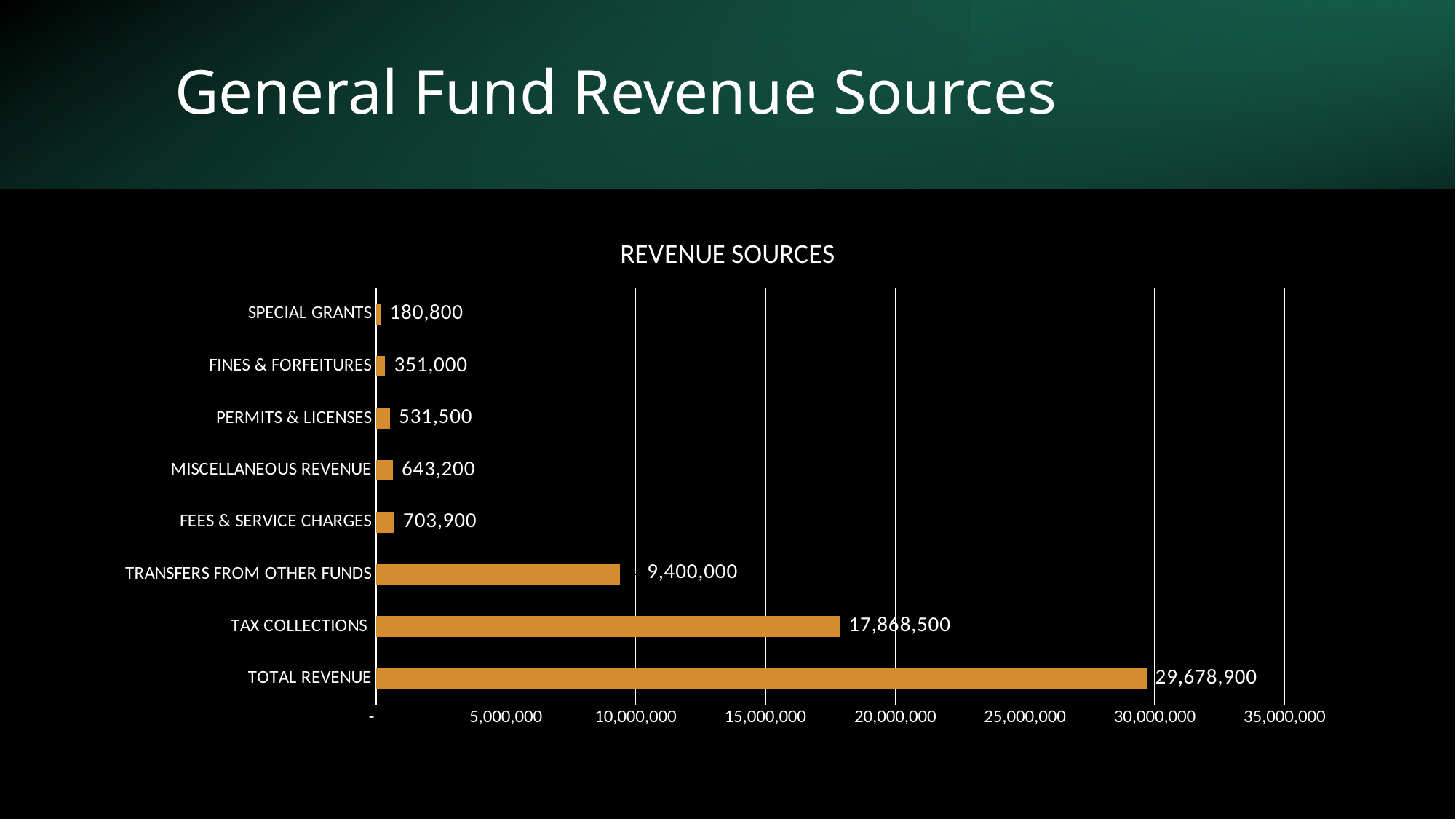
How many categories are shown in the chart? 8 What is the value for TRANSFERS FROM OTHER FUNDS? 9,400,000 What is the title of the chart? REVENUE SOURCES Which category has the lowest value? SPECIAL GRANTS What kind of chart is shown on the slide? Bar chart What is the value for FEES & SERVICE CHARGES? 703,900 What is the value for SPECIAL GRANTS? 180,800 What is the difference between MISCELLANEOUS REVENUE and PERMITS & LICENSES? 111,700 Which is larger, FINES & FORFEITURES or PERMITS & LICENSES? PERMITS & LICENSES What is the difference between TAX COLLECTIONS and TRANSFERS FROM OTHER FUNDS? 8,468,500 Which category has the highest value? TOTAL REVENUE What is the value for TAX COLLECTIONS? 17,868,500